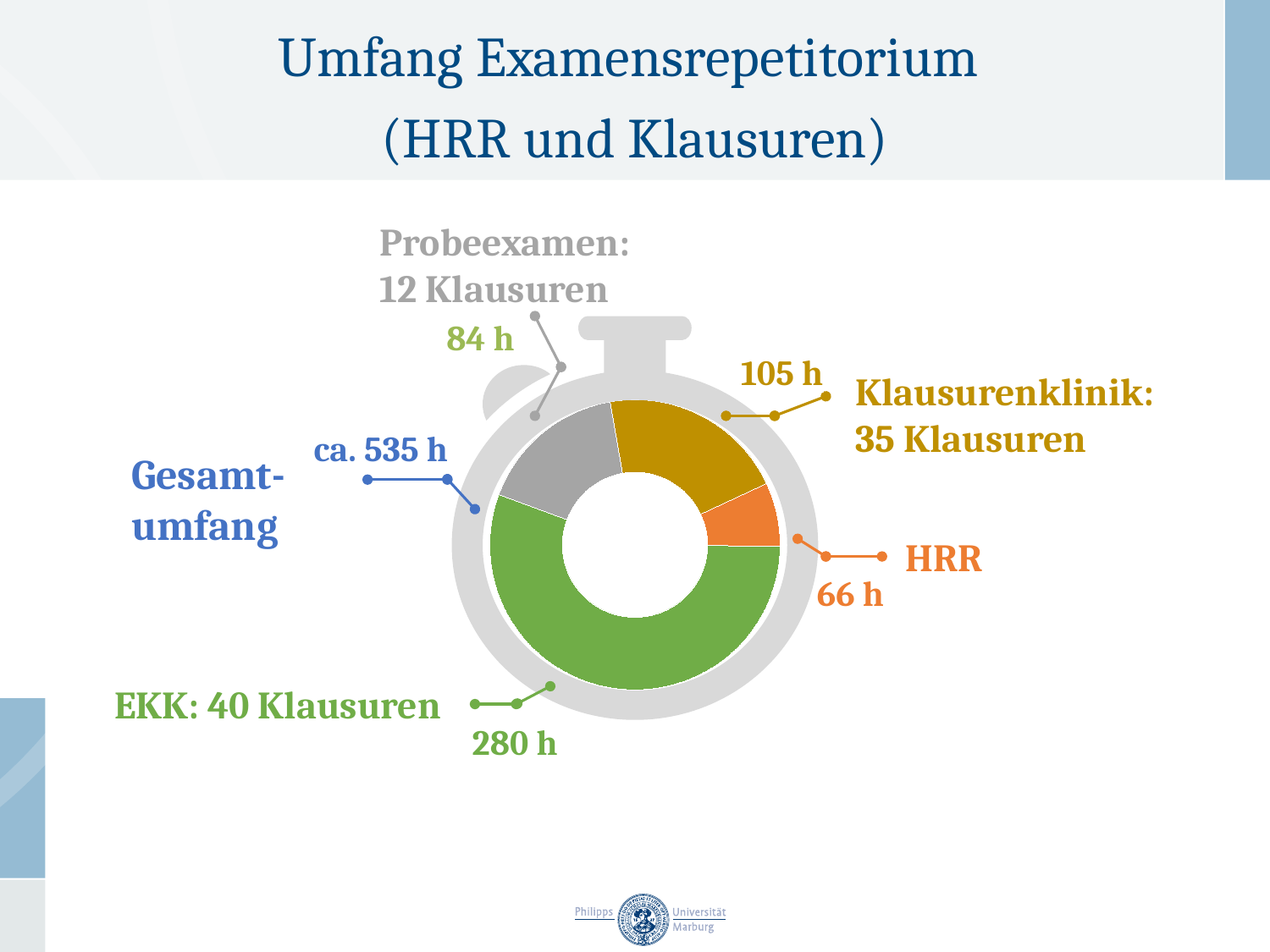
How many hours are shown for Probeexamen? 84 h How many segments does the donut chart have? 4 What total is given for the Gesamtumfang? ca. 535 h How many hours are shown for HRR? 66 h How many Klausuren are listed for Klausurenklinik? 35 Klausuren How many hours are shown for Klausurenklinik? 105 h Which segment of the chart has the smallest number of hours? HRR What kind of chart is shown on the slide? Donut (pie) chart Which has more hours, Klausurenklinik or Probeexamen? Klausurenklinik Which segment of the chart has the largest number of hours? EKK What is the difference in hours between EKK and Klausurenklinik? 175 h How many hours are shown for EKK? 280 h